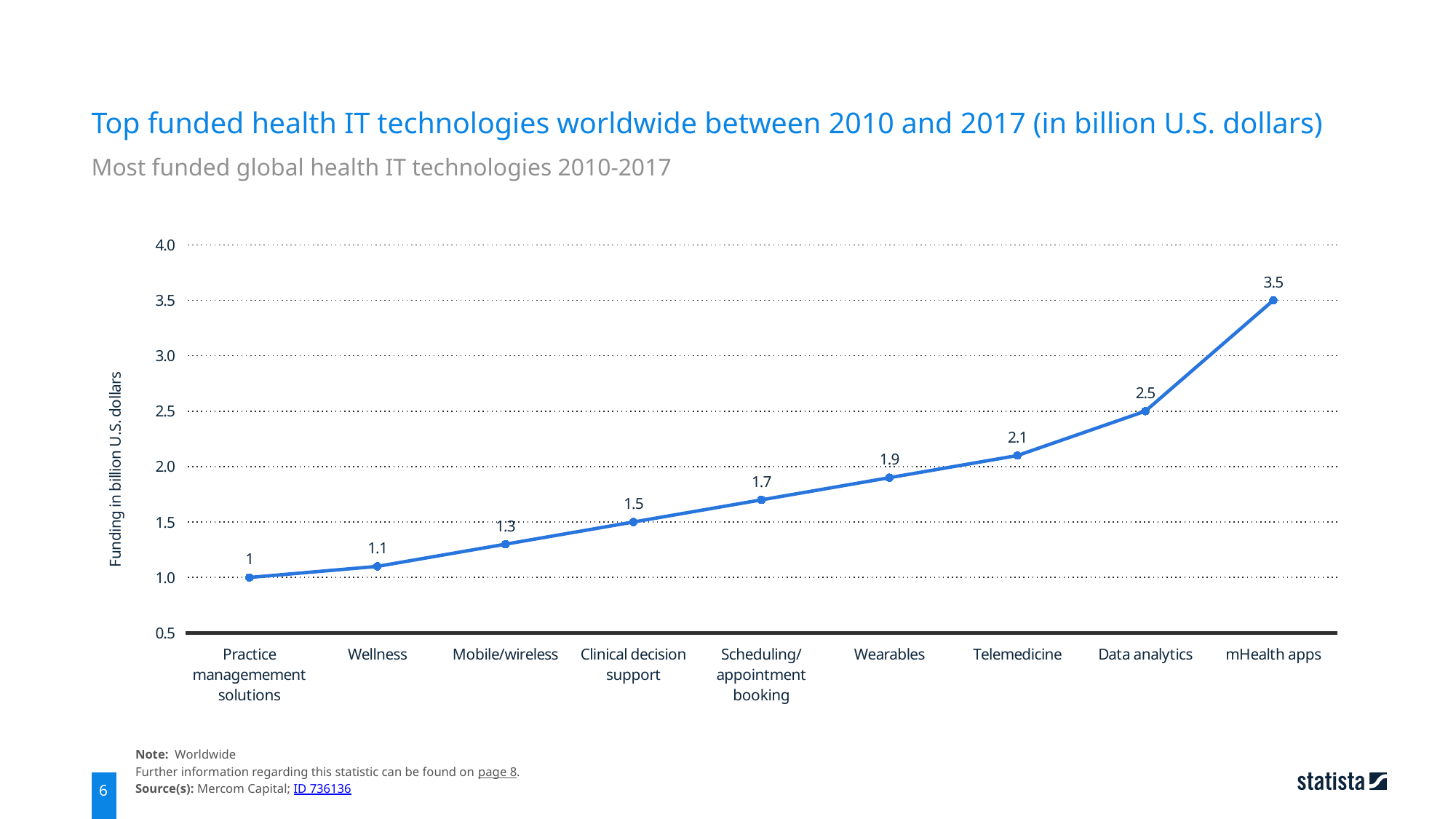
What is the funding value for Practice management solutions? 1 What is the funding value for Telemedicine? 2.1 What is the funding value for mHealth apps? 3.5 What is the difference in funding between mHealth apps and Data analytics? 1 Which technology has the highest funding? mHealth apps How many technologies are plotted on the chart? 9 Which has higher funding, Clinical decision support or Scheduling/appointment booking? Scheduling/appointment booking What is the label of the y axis? Funding in billion U.S. dollars What kind of chart is shown on the slide? Line chart Do the values rise or fall from left to right along the x axis? Rise Which technology has the lowest funding? Practice management solutions What is the difference in funding between Wearables and Wellness? 0.8